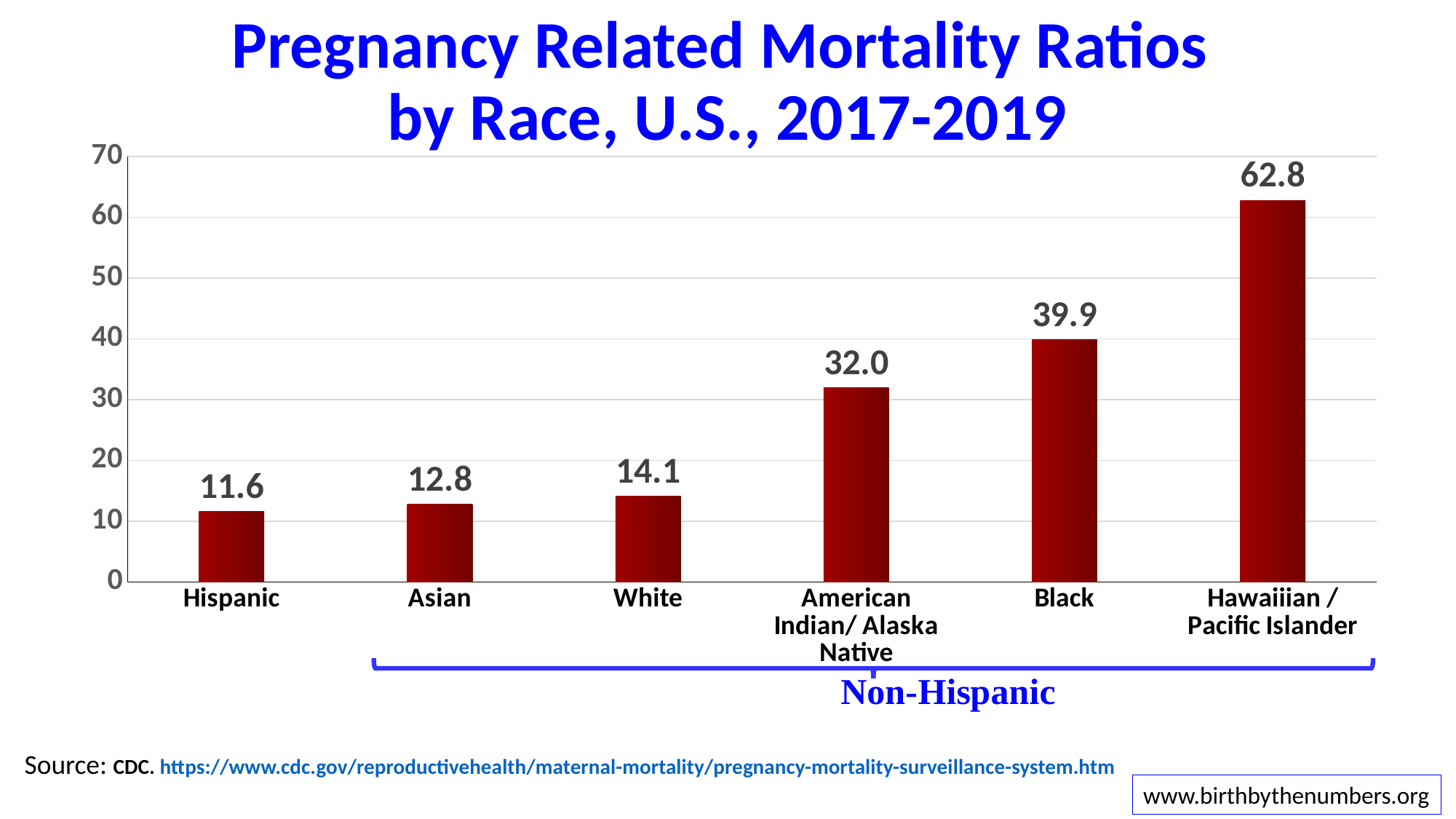
What is the difference between the values for Hawaiiian / Pacific Islander and Black? 22.9 What is the difference between the values for White and Asian? 1.3 How many race categories are shown in the chart? 6 Which categories are grouped under the 'Non-Hispanic' bracket below the x axis? Asian, White, American Indian/ Alaska Native, Black, Hawaiiian / Pacific Islander Is the value for Hawaiiian / Pacific Islander greater or less than 60? greater Which is larger, the value for Black or the value for American Indian/ Alaska Native? Black What is the pregnancy related mortality ratio for Hispanic women? 11.6 Which race has the lowest pregnancy related mortality ratio? Hispanic What kind of chart is shown on the slide? Bar chart What is the value shown for American Indian/ Alaska Native? 32.0 What is the pregnancy related mortality ratio for Black women? 39.9 Which race has the highest pregnancy related mortality ratio? Hawaiiian / Pacific Islander